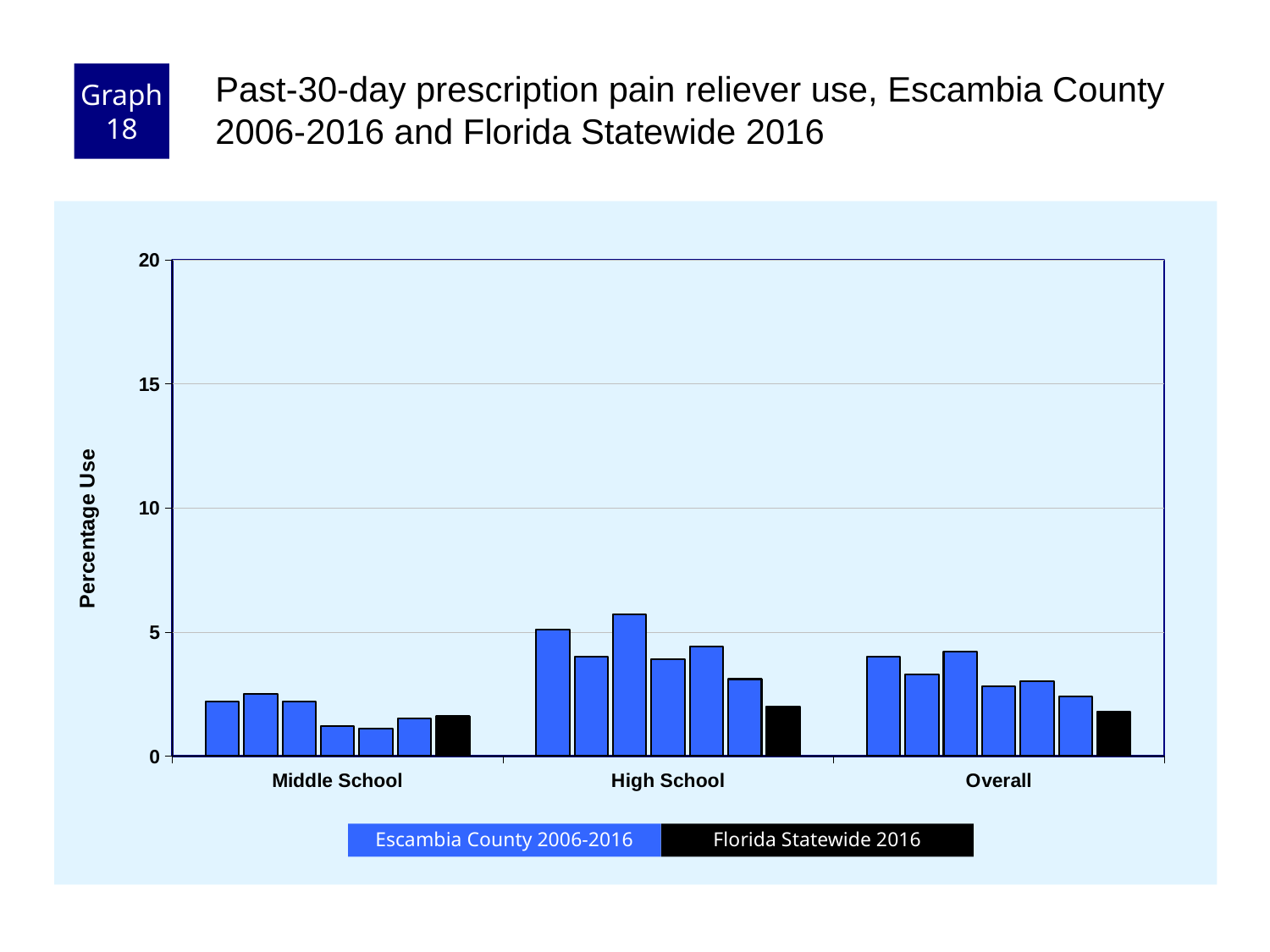
How many categories are shown on the x axis? 3 Is the tallest Escambia County bar in the High School group greater or less than 5? greater How many series does the legend list? 2 What colour represents Florida Statewide 2016 in the legend? black What kind of chart is shown on the slide? bar chart Which is larger, the Florida Statewide 2016 value for High School or for Middle School? High School Is the Florida Statewide 2016 value for High School greater or less than 5? less Which category has the highest bars overall? High School Which category has the lowest bars overall? Middle School Is the Florida Statewide 2016 value for Middle School greater or less than 5? less What is the label on the y axis? Percentage Use